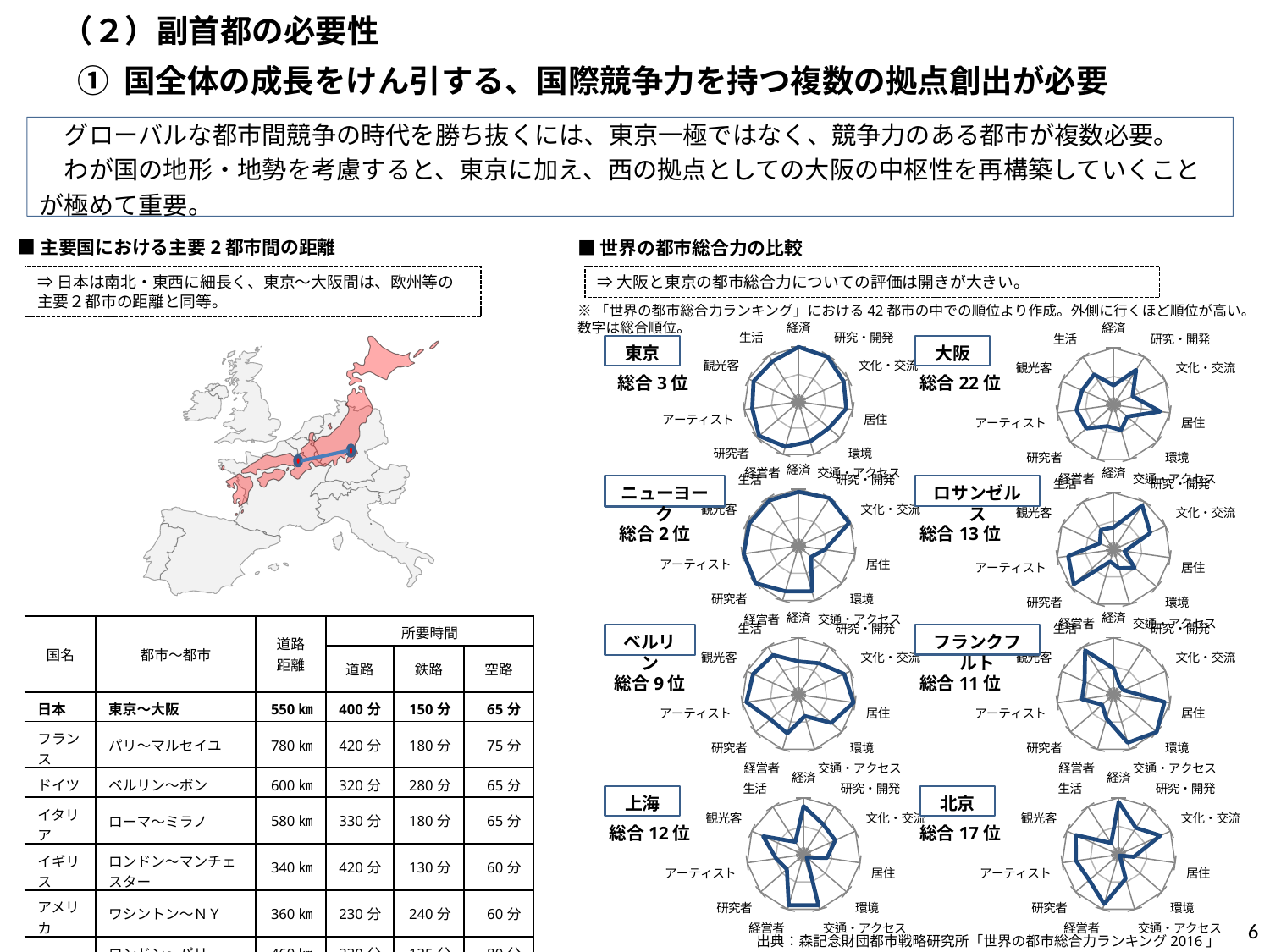
In the 「世界の都市総合力の比較」 section, what overall rank is shown for 上海? 総合 12 位 In the 「世界の都市総合力の比較」 section, which of the eight cities shown has the best overall rank? ニューヨーク In the 「世界の都市総合力の比較」 section, what overall rank is shown for 東京? 総合 3 位 In the 「世界の都市総合力の比較」 section, what overall rank is shown for ニューヨーク? 総合 2 位 In the 「世界の都市総合力の比較」 section, what overall rank is shown for ロサンゼルス? 総合 13 位 How many radar charts are shown in the 「世界の都市総合力の比較」 section? 8 In the 「世界の都市総合力の比較」 section, what overall rank is shown for フランクフルト? 総合 11 位 In the 「世界の都市総合力の比較」 section, which city has the better (higher) overall rank, 東京 or 大阪? 東京 In the 「世界の都市総合力の比較」 section, what overall rank is shown for 大阪? 総合 22 位 What kind of chart is used in the 「世界の都市総合力の比較」 section to compare the cities? radar chart In the 「世界の都市総合力の比較」 section, what overall rank is shown for ベルリン? 総合 9 位 How many evaluation axes (categories) does each radar chart in the 「世界の都市総合力の比較」 section have? 11